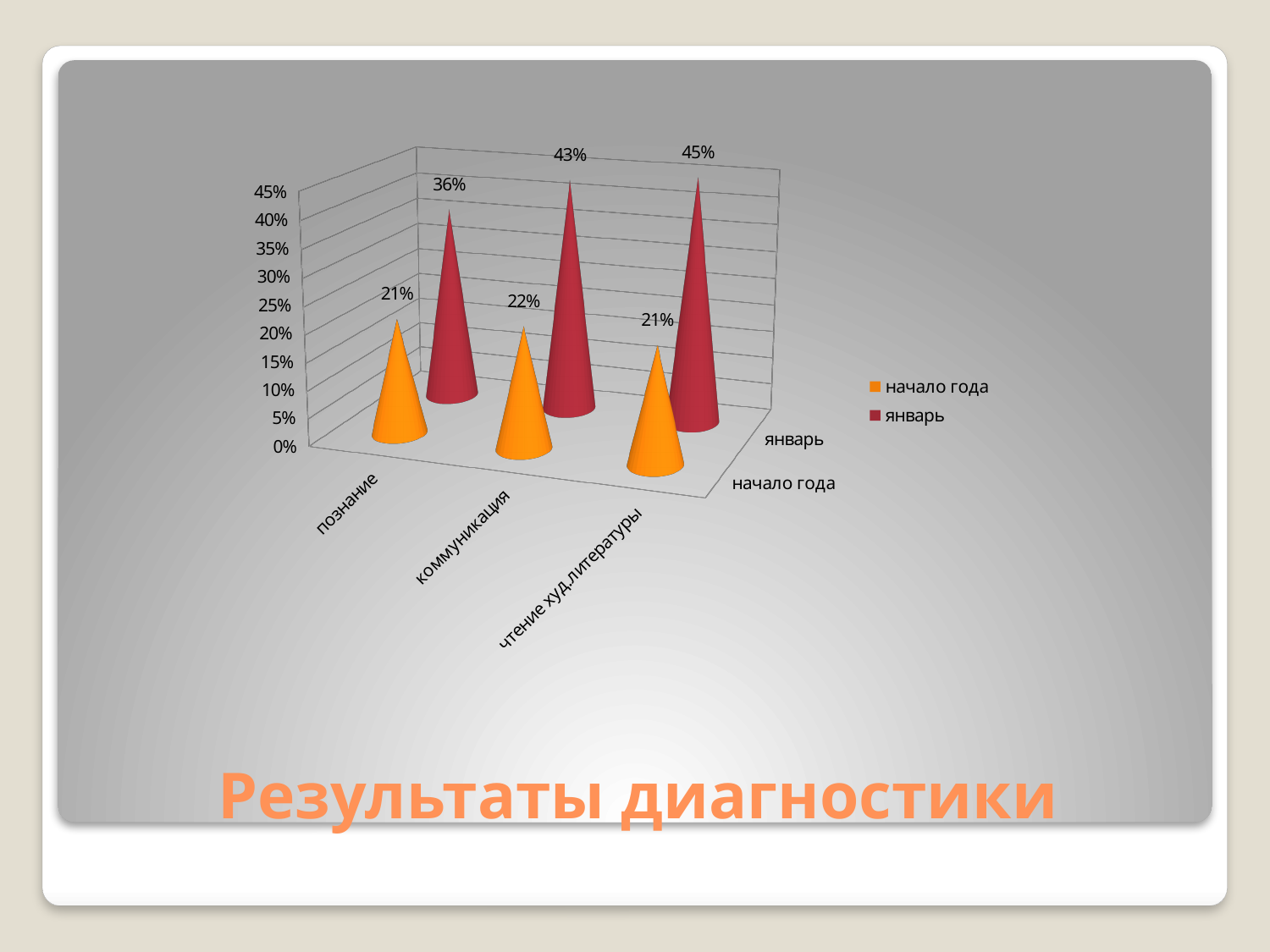
Which colour represents the январь series in the legend? red Which category has the highest value in the январь series? чтение худ.литературы What kind of chart is shown on the slide? bar chart Which is larger for познание: the начало года value or the январь value? январь How many series does the legend list? 2 What is the difference between the январь and начало года values for чтение худ.литературы? 24% What is the value for коммуникация in the начало года series? 22% What is the value for познание in the январь series? 36% How many categories are shown on the chart? 3 What is the difference between the январь and начало года values for коммуникация? 21% Which category has the lowest value in the январь series? познание What is the value for чтение худ.литературы in the январь series? 45%